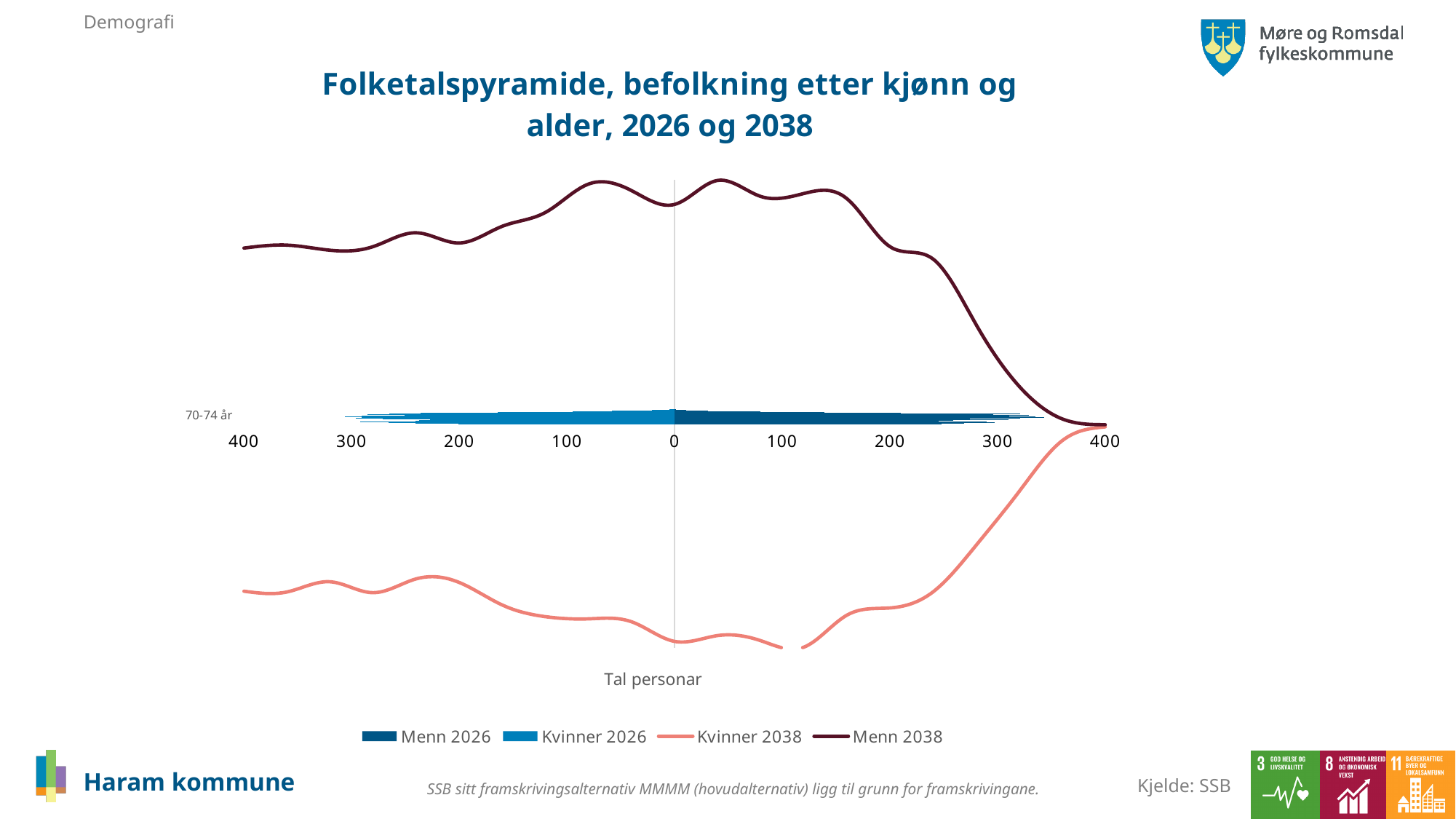
Which two years are compared in the chart? 2026 and 2038 How many series does the legend list? 4 What is the title of the chart? Folketalspyramide, befolkning etter kjønn og alder, 2026 og 2038 What is the highest value shown on the horizontal axis? 400 Which series are shown as lines rather than bars in the legend? Kvinner 2038 and Menn 2038 What is the label of the horizontal axis? Tal personar What kind of chart is this? A combined bar and line chart (population pyramid)